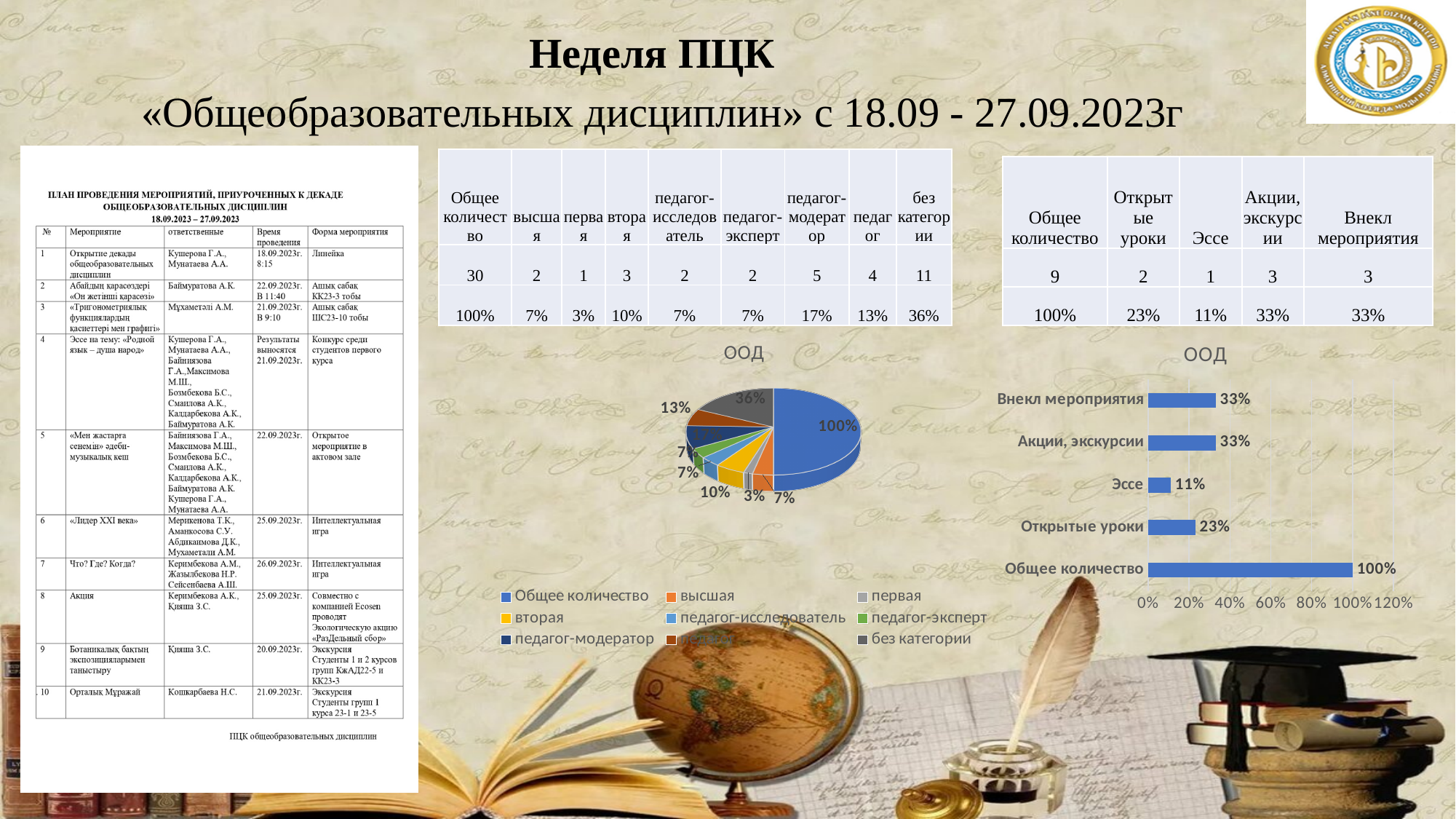
On the bar chart on the right, what is the value for Внекл мероприятия? 33% On the pie chart in the middle of the slide, what is the share labelled for первая? 3% On the bar chart on the right, what is the value for Открытые уроки? 23% On the pie chart in the middle of the slide, what is the share labelled for без категории? 36% What kind of chart is the chart on the right of the slide? bar chart How many entries does the legend of the pie chart in the middle of the slide list? 9 On the pie chart in the middle of the slide, which of первая or педагог has the larger share? педагог On the bar chart on the right, what is the difference between the values for Открытые уроки and Эссе? 12% What is the title of the pie chart in the middle of the slide? ООД On the bar chart on the right, what is the value for Эссе? 11% On the bar chart on the right, which category has the lowest value? Эссе On the bar chart on the right, how many categories are plotted? 5